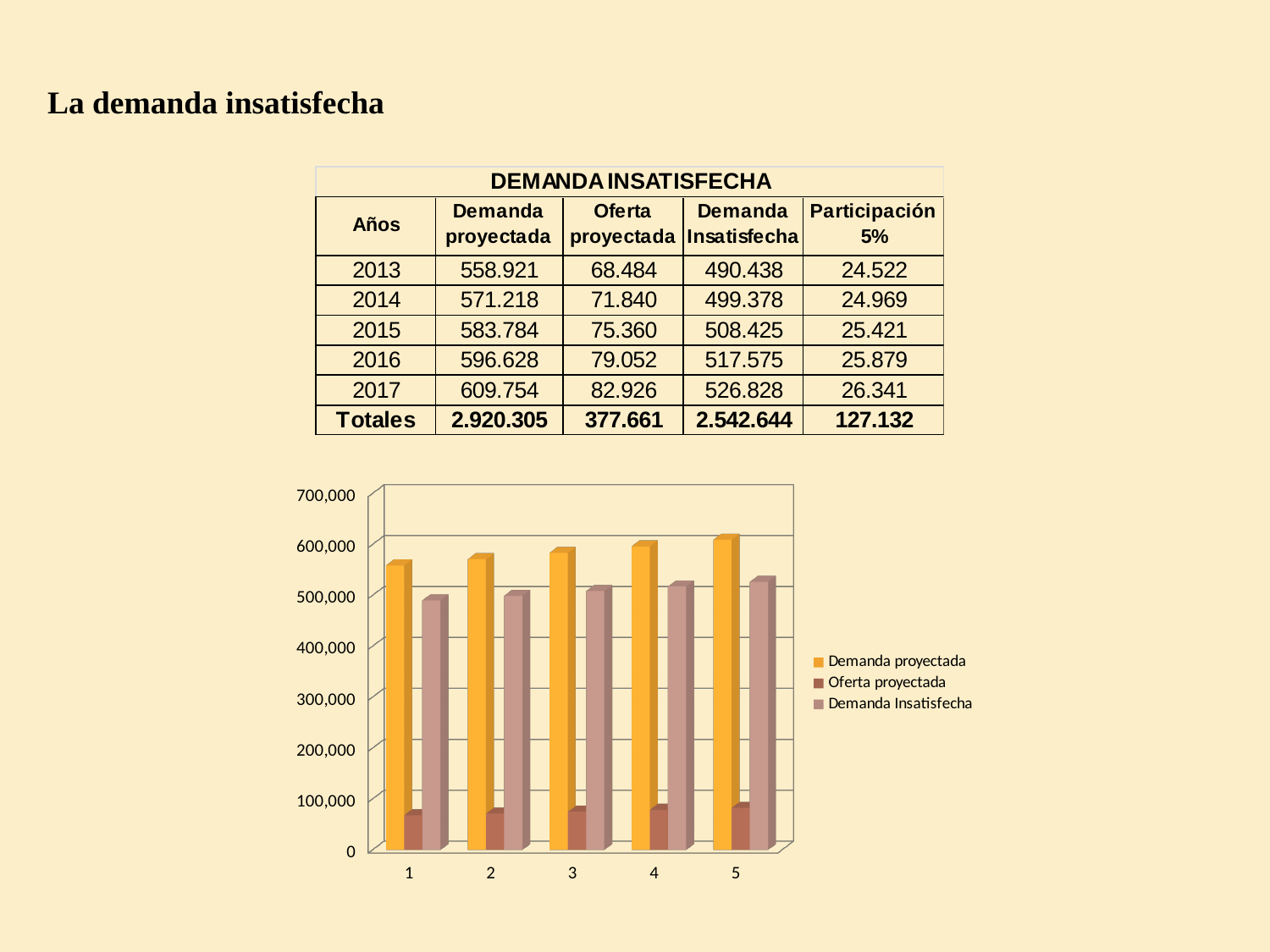
Is the Demanda Insatisfecha value for category 5 greater or less than 500,000? greater How many categories are shown on the x axis of the chart? 5 Which series has the tallest bars in the chart? Demanda proyectada Is the Oferta proyectada value for category 1 greater or less than 100,000? less For category 3, which is larger: Demanda proyectada or Oferta proyectada? Demanda proyectada Is the Demanda proyectada value for category 1 greater or less than 500,000? greater Which series has the shortest bars in the chart? Oferta proyectada What is the highest value shown on the chart's y axis? 700,000 What kind of chart is shown on the slide? bar chart For category 2, which is larger: Demanda Insatisfecha or Oferta proyectada? Demanda Insatisfecha Do the Demanda proyectada bars rise or fall from category 1 to category 5? rise How many series does the chart legend list? 3